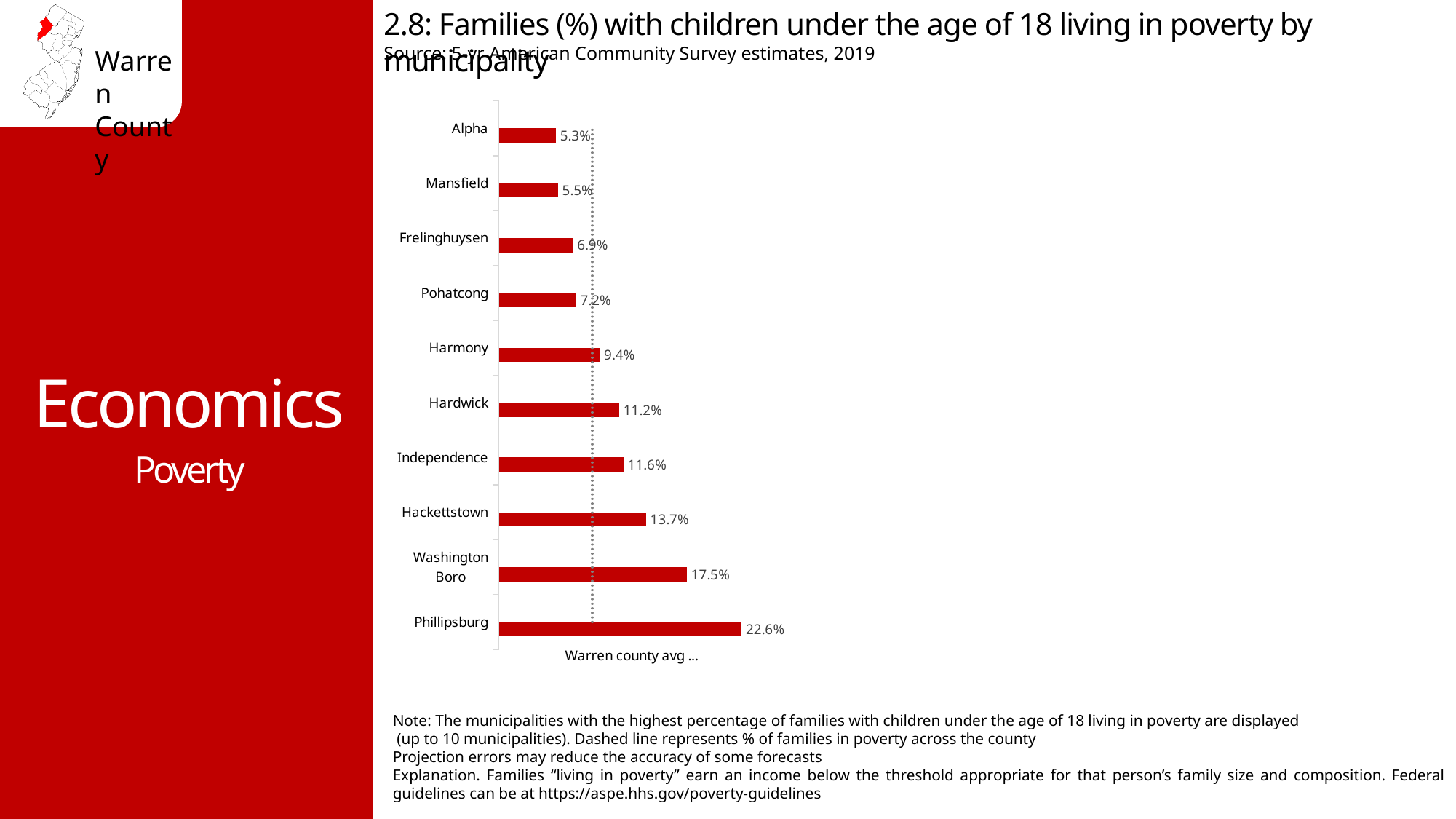
What does the dashed vertical line on the chart represent? Warren county average (% of families in poverty across the county) Which has a higher value, Hardwick or Pohatcong? Hardwick What is the difference between the values for Phillipsburg and Washington Boro? 5.1% What is the value shown for Washington Boro? 17.5% What is the difference between the values for Hackettstown and Harmony? 4.3% What is the value shown for Hackettstown? 13.7% Which municipality has the lowest percentage shown on the chart? Alpha What is the value shown for Harmony? 9.4% How many municipalities are shown on the chart? 10 Which municipality has the highest percentage of families with children living in poverty? Phillipsburg What percentage of families with children under 18 are living in poverty in Phillipsburg? 22.6% What type of chart is used on this slide? Bar chart